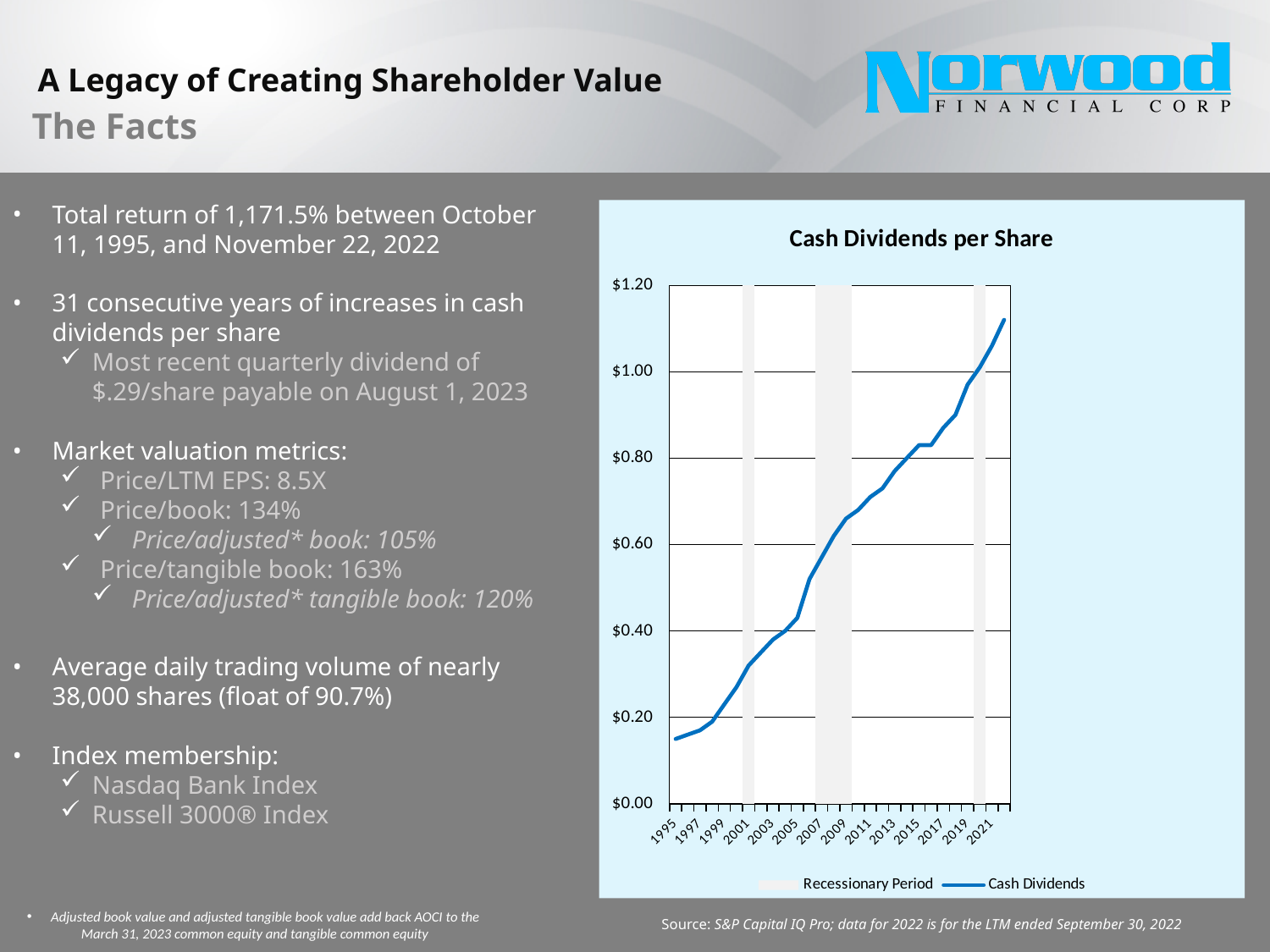
In which year shown on the x axis is the cash dividend per share lowest? 1995 How many entries does the chart legend list? 2 What kind of chart is shown on the slide? line chart Which year has the larger cash dividend per share, 2005 or 2011? 2011 Do cash dividends per share rise or fall from 1995 to the end of the period? rise What is the title of the chart? Cash Dividends per Share Is the cash dividend per share in 2001 greater or less than $0.40? less What do the grey shaded vertical bands on the chart represent, according to the legend? Recessionary Period Is the cash dividend per share in 2021 greater or less than $1.00? greater Is the cash dividend per share in 2013 greater or less than $0.60? greater What is the highest value shown on the chart's y axis? $1.20